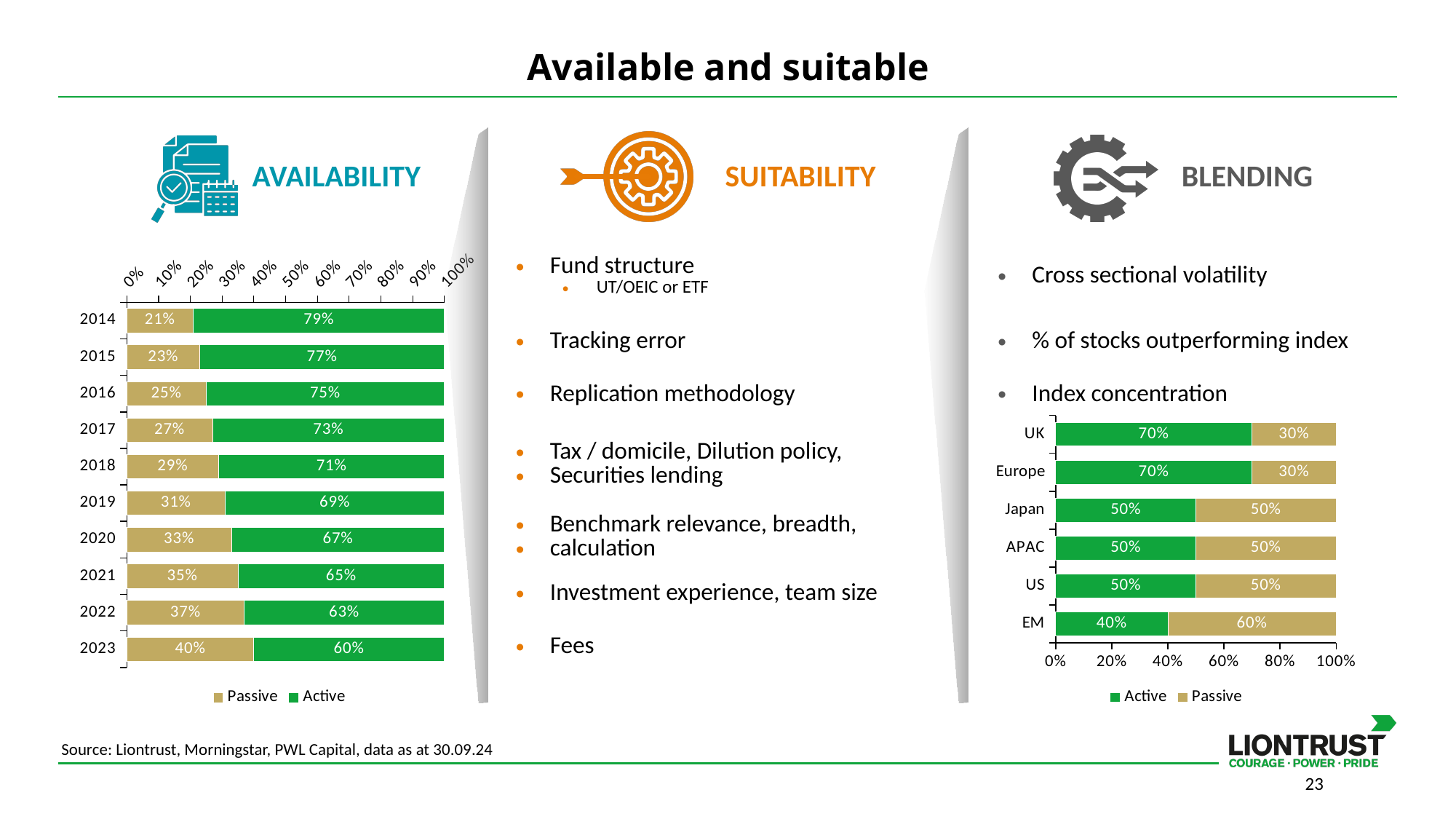
In the right-hand chart under Index concentration, what is the Active value for EM? 40% In the left-hand chart under AVAILABILITY, what is the Active value for 2023? 60% In the left-hand chart under AVAILABILITY, which year has the lowest Active value? 2023 In the left-hand chart under AVAILABILITY, what is the difference between the Passive values for 2023 and 2014? 19% In the left-hand chart under AVAILABILITY, how many years are shown? 10 In the right-hand chart under Index concentration, is the Active value for UK larger or smaller than the Active value for Japan? larger In the left-hand chart under AVAILABILITY, what is the Passive value for 2014? 21% In the left-hand chart under AVAILABILITY, which year has the highest Passive value? 2023 In the left-hand chart under AVAILABILITY, what kind of chart is it? stacked bar chart In the left-hand chart under AVAILABILITY, does the Passive value rise or fall from 2014 to 2023? rise In the right-hand chart under Index concentration, which region has the highest Passive value? EM In the right-hand chart under Index concentration, how many series does the legend list? 2